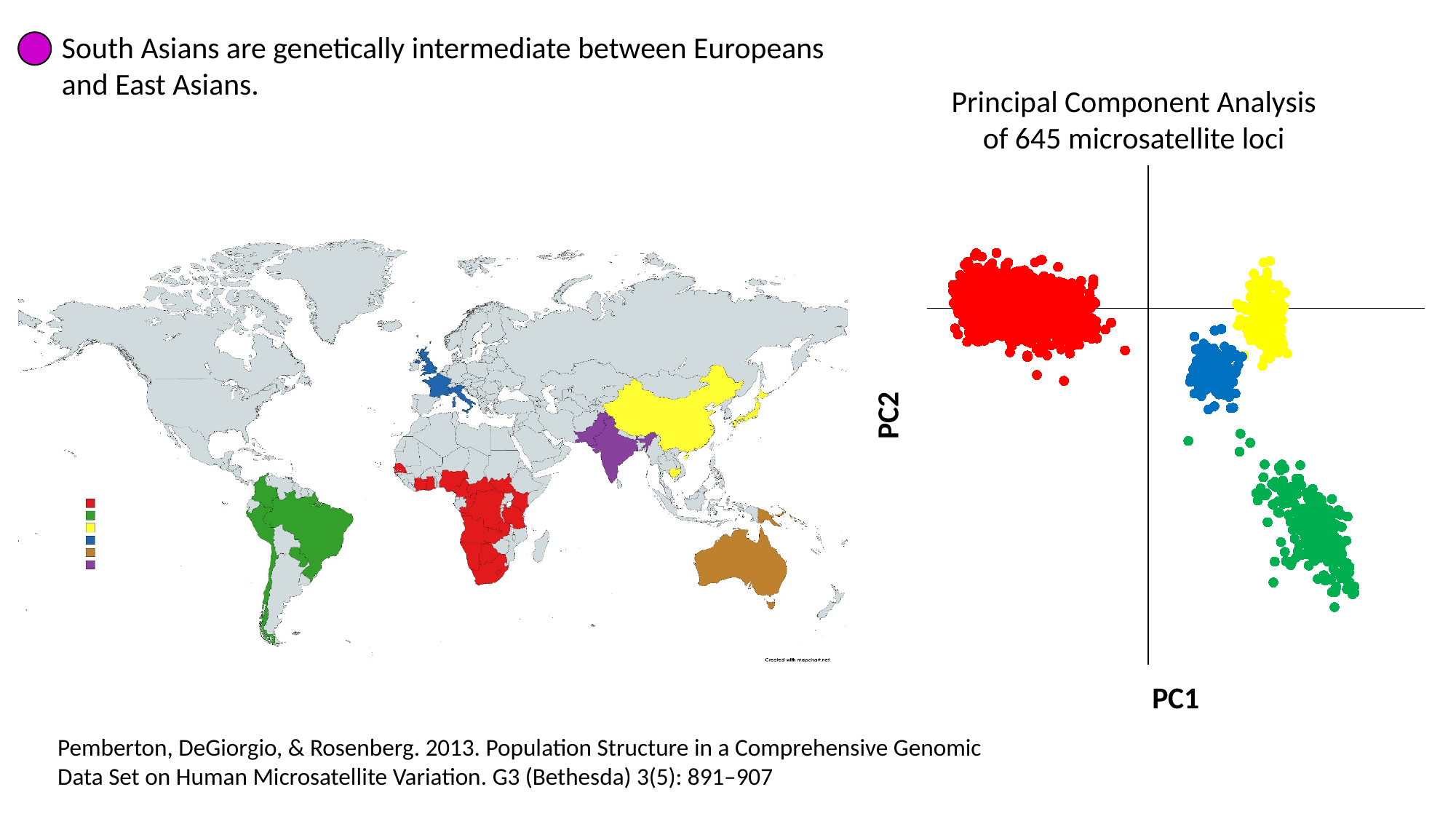
In the Principal Component Analysis chart, which coloured cluster has the highest PC1 values? green In the Principal Component Analysis chart, which cluster is further right on PC1, the red cluster or the yellow cluster? yellow In the Principal Component Analysis chart, what is the label of the horizontal axis? PC1 In the Principal Component Analysis chart, which cluster is higher on PC2, the blue cluster or the green cluster? blue In the Principal Component Analysis chart, which coloured cluster has the lowest PC2 values? green In the Principal Component Analysis chart, how many distinct coloured clusters of points are plotted? 4 What is the title of the chart on the right side of the slide? Principal Component Analysis of 645 microsatellite loci In the Principal Component Analysis chart, which coloured cluster has the lowest PC1 values? red What kind of chart is the chart titled "Principal Component Analysis of 645 microsatellite loci"? scatter plot How many microsatellite loci does the title of the Principal Component Analysis chart say were analysed? 645